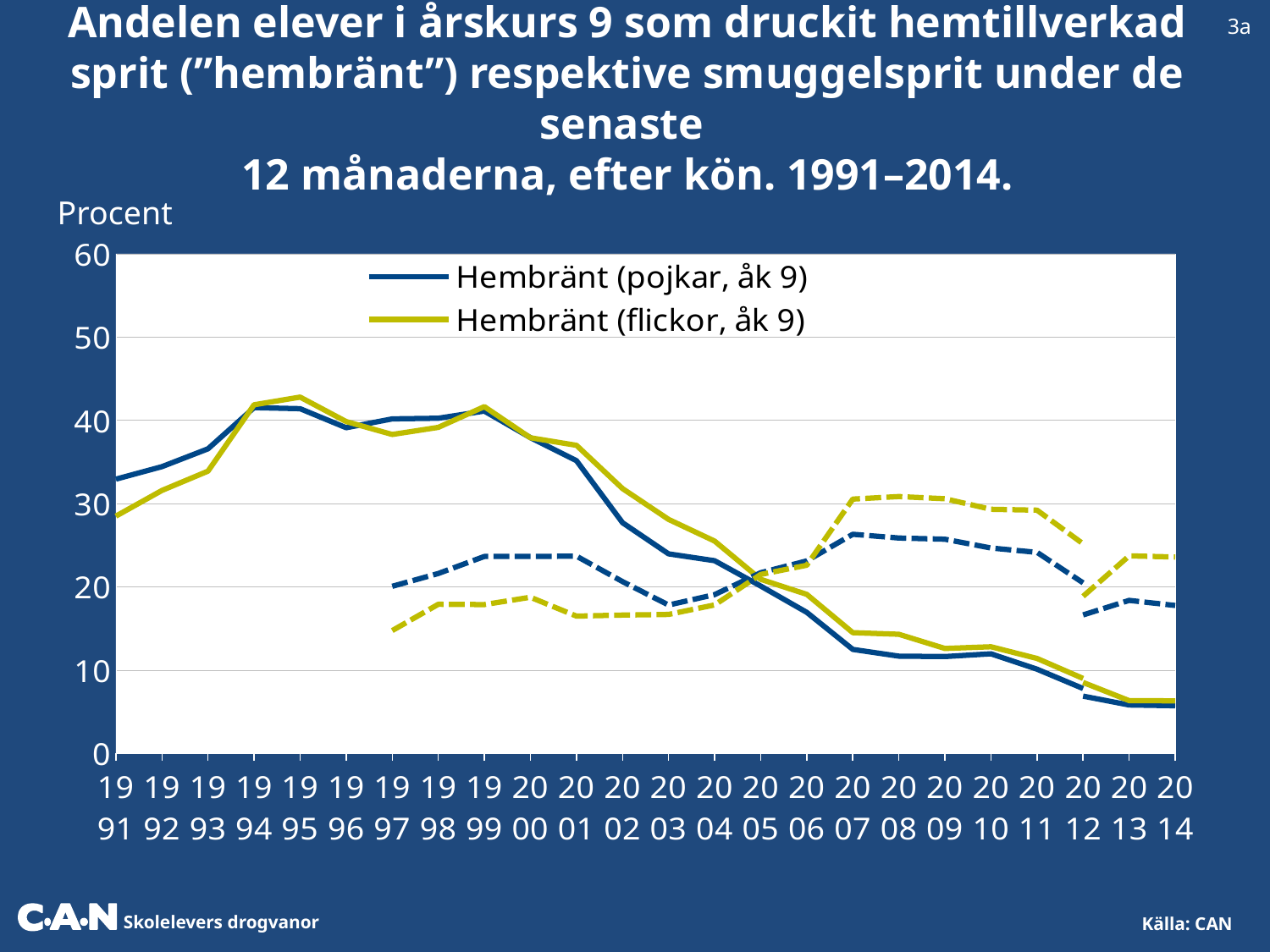
How many years are shown along the x axis? 24 Which colour is used for the series 'Hembränt (flickor, åk 9)'? yellow-green Is the value for 'Hembränt (flickor, åk 9)' in 2007 greater or less than 20? less What kind of chart is shown on the slide? line chart Is the value for 'Hembränt (pojkar, åk 9)' in 1991 greater or less than 30? greater Is the value for 'Hembränt (pojkar, åk 9)' in 2014 greater or less than 10? less What is the label on the vertical axis? Procent Does the 'Hembränt (pojkar, åk 9)' series generally rise or fall from 1999 to 2014? fall In 2003, which series has the higher value: 'Hembränt (pojkar, åk 9)' or 'Hembränt (flickor, åk 9)'? Hembränt (flickor, åk 9) How many series does the legend list? 2 In 1991, which series has the higher value: 'Hembränt (pojkar, åk 9)' or 'Hembränt (flickor, åk 9)'? Hembränt (pojkar, åk 9)